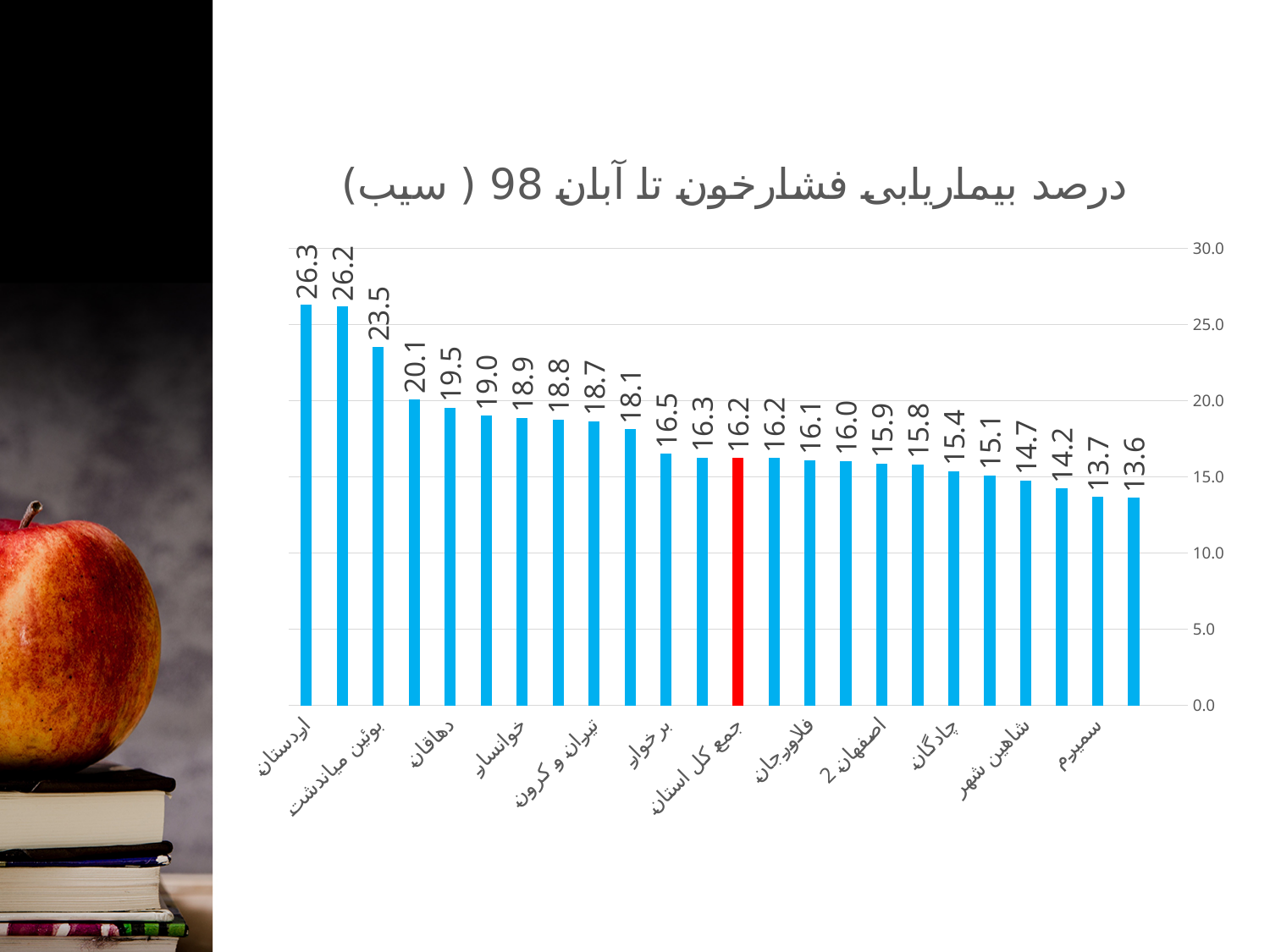
Which category has the highest value? اردستان What is the value for بوئین میاندشت? 23.5 Do the values rise or fall from left to right along the x axis? fall What kind of chart is shown on the slide? bar chart How many bars are plotted in the chart? 24 Which is larger, the value for دهاقان or the value for فلاورجان? دهاقان What is the value for جمع کل استان (the red bar)? 16.2 Is the value for چادگان greater or less than 20.0? less What is the lowest value shown in the chart? 13.6 What is the value for سمیرم? 13.7 What is the value for اردستان? 26.3 What is the difference between the values for اردستان and سمیرم? 12.6